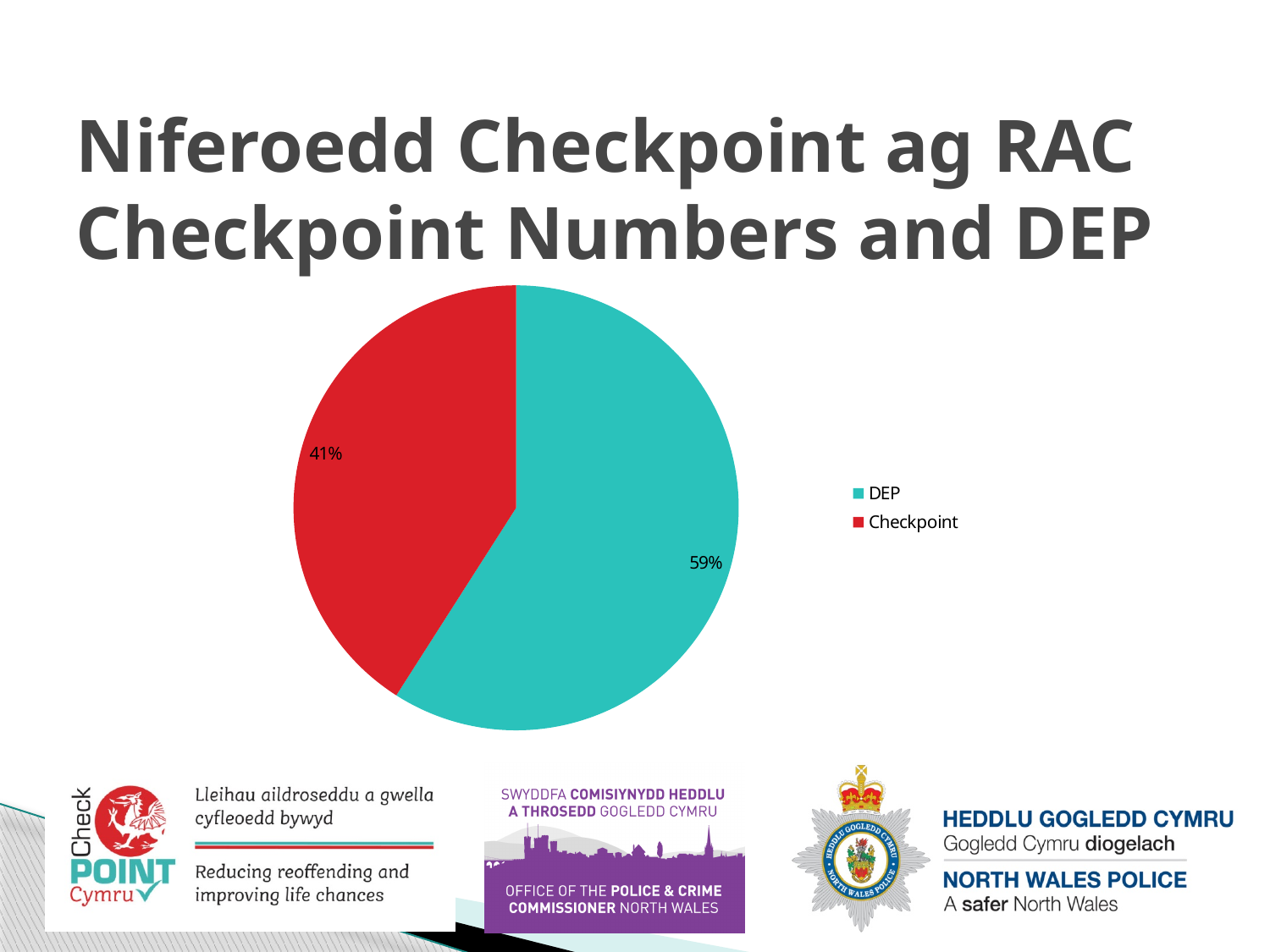
How many slices does the pie chart have? 2 Which slice is the smallest in the pie chart? Checkpoint What is the difference in percentage points between the DEP and Checkpoint slices? 18 What share of the pie does Checkpoint represent? 41% What share of the pie does DEP represent? 59% What kind of chart is shown on the slide? Pie chart Is the share for DEP greater or less than 50%? greater What colour is the DEP slice in the pie chart? Teal How many entries does the legend list? 2 Which slice is the largest in the pie chart? DEP What colour is the Checkpoint slice in the pie chart? Red Which is larger, the DEP slice or the Checkpoint slice? DEP